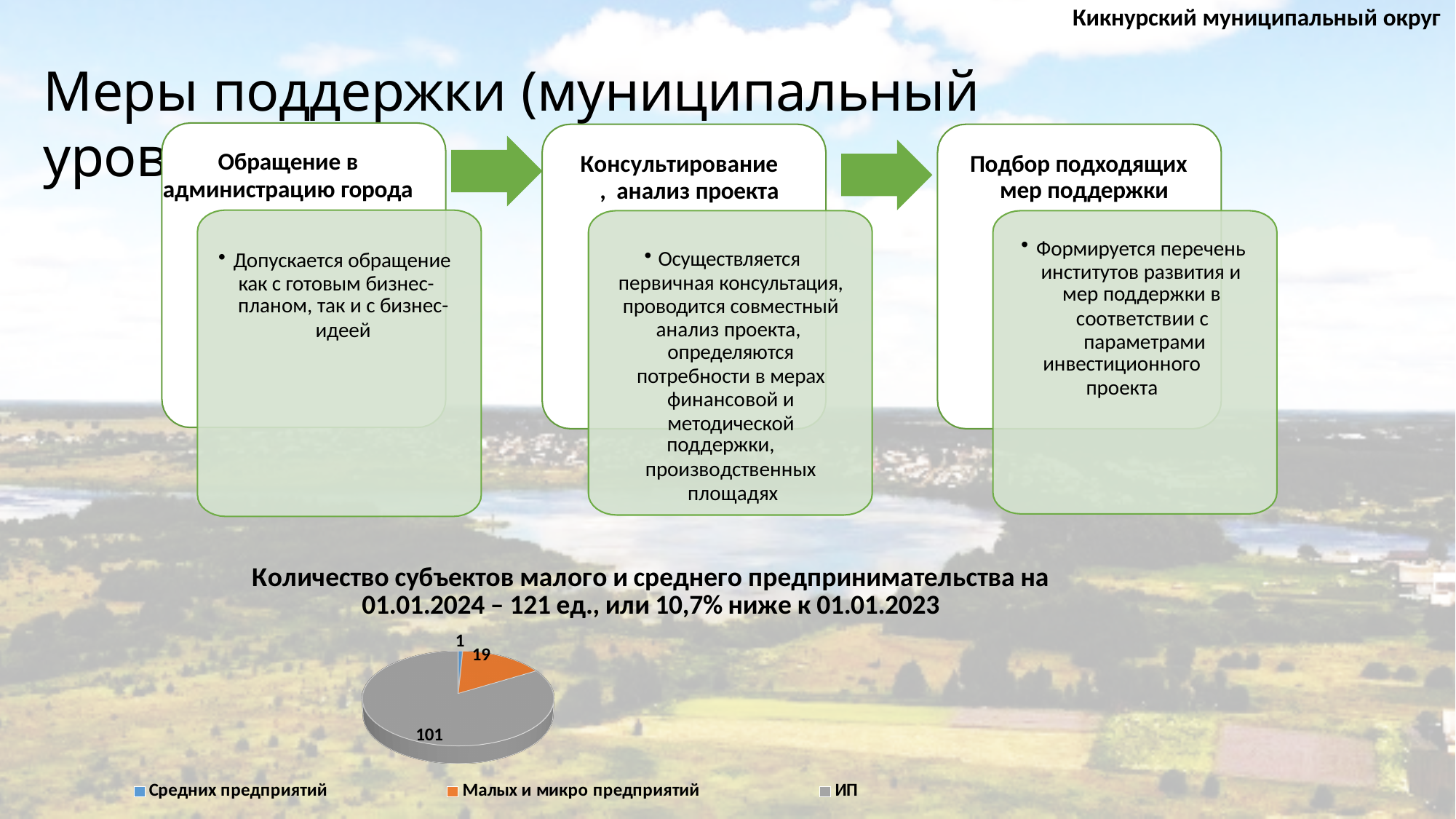
What is the value for Малых и микро предприятий in the pie chart? 19 Which is larger: the value for Малых и микро предприятий or the value for Средних предприятий? Малых и микро предприятий Which category has the largest slice in the pie chart? ИП How many entries does the legend of the pie chart list? 3 What is the value for Средних предприятий in the pie chart? 1 What is the difference between the values for ИП and Малых и микро предприятий? 82 What kind of chart is shown on the slide? pie chart Which category has the smallest slice in the pie chart? Средних предприятий Which colour represents ИП in the pie chart? gray What is the value for ИП in the pie chart? 101 How many slices does the pie chart have? 3 What is the total of all slices in the pie chart? 121